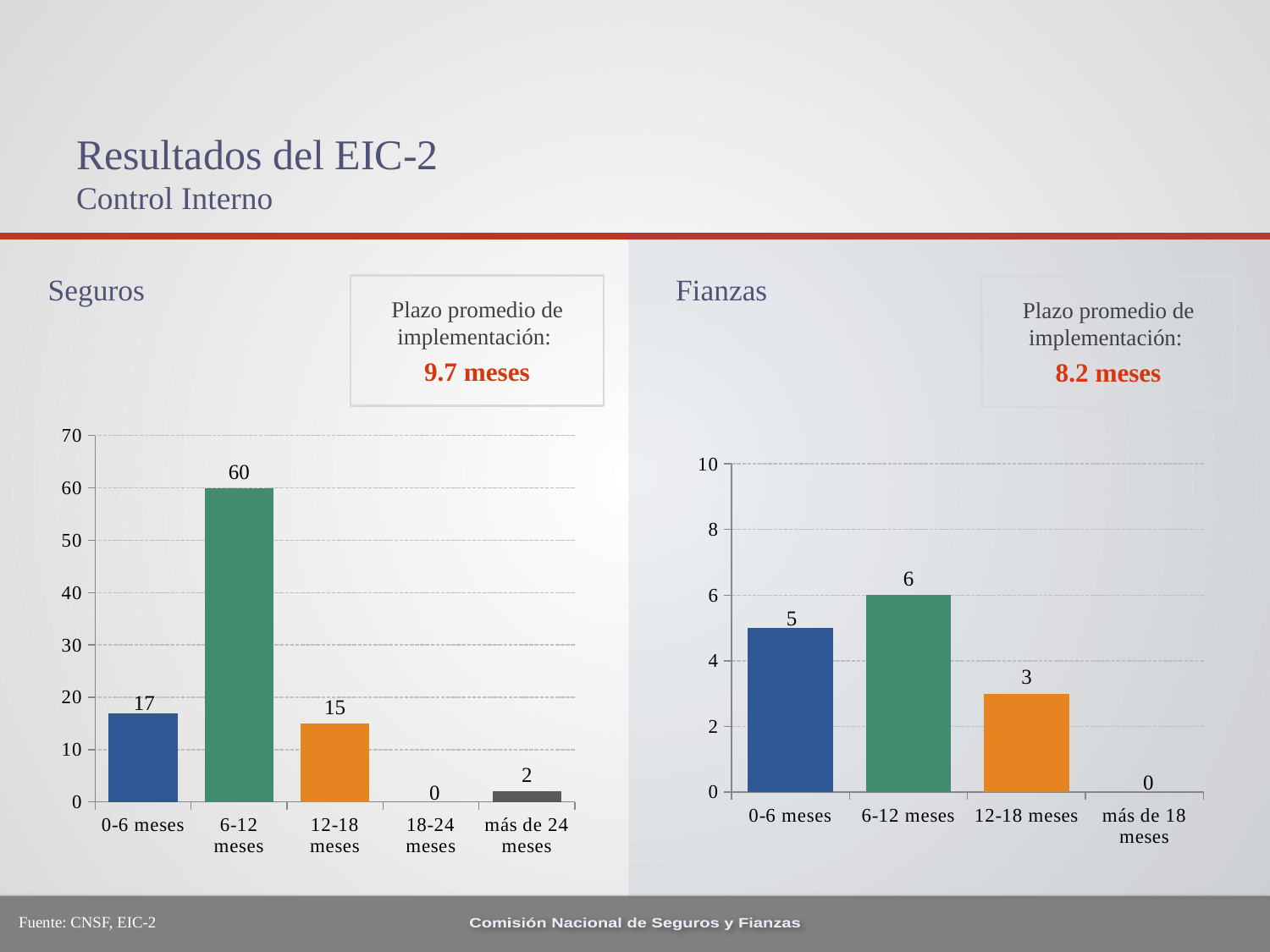
In the Fianzas chart, which category has the highest value? 6-12 meses In the Seguros chart, what is the value for más de 24 meses? 2 In the Seguros chart, how many categories are shown on the x axis? 5 In the Seguros chart, what is the difference between the values for 0-6 meses and 12-18 meses? 2 In the Seguros chart, which category has the lowest value? 18-24 meses What kind of chart is the Fianzas chart? Bar chart In the Fianzas chart, what is the difference between the values for 6-12 meses and 0-6 meses? 1 In the Seguros chart, which category has the highest value? 6-12 meses In the Fianzas chart, which is larger, the value for 0-6 meses or the value for 12-18 meses? 0-6 meses In the Fianzas chart, what is the value for 12-18 meses? 3 What is the average implementation period (plazo promedio de implementación) shown for Seguros? 9.7 meses In the Seguros chart, what is the value for 6-12 meses? 60